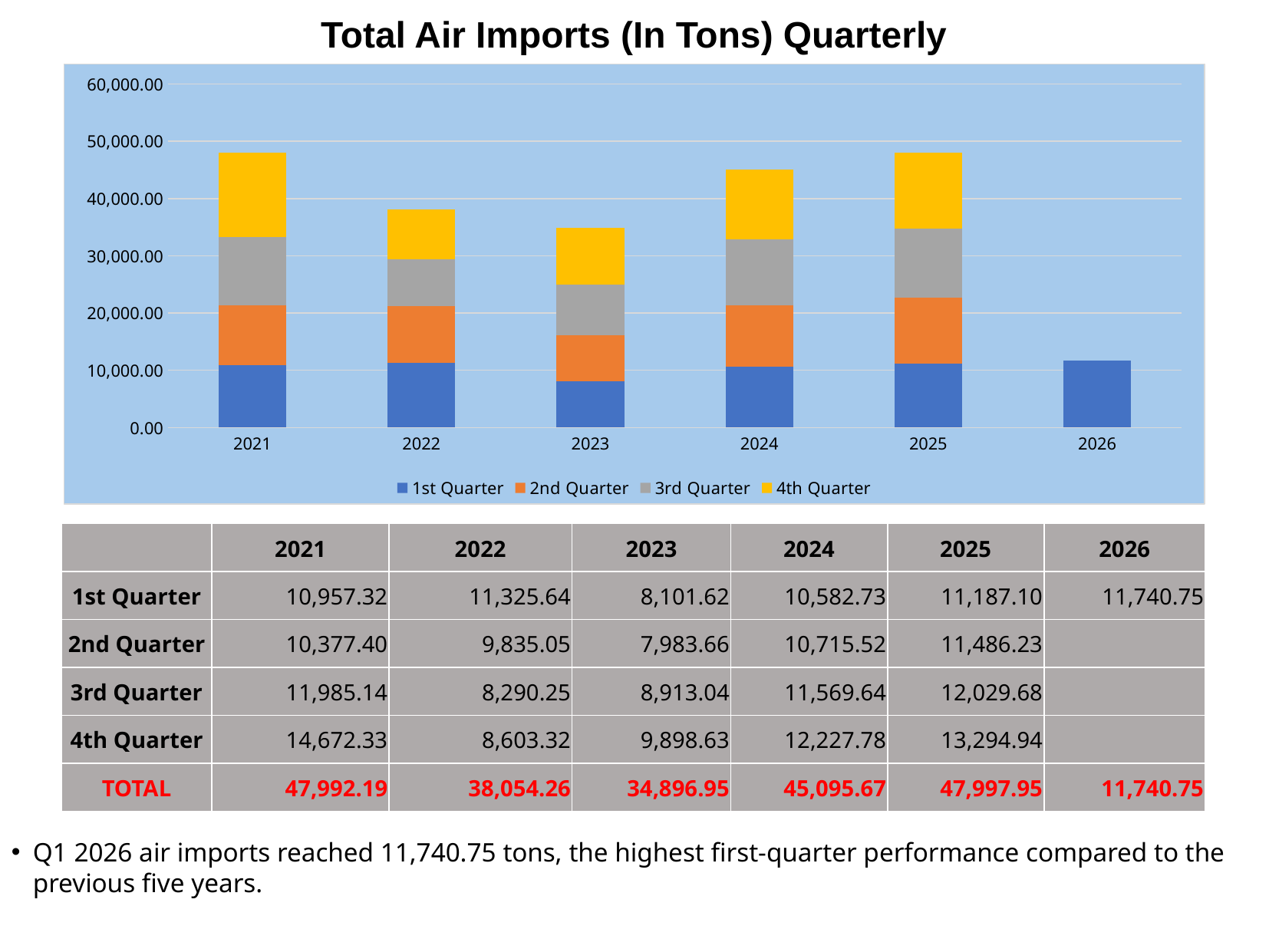
What is the total of the stacked bar for 2022? 38,054.26 How many series does the legend list? 4 Do the total stacked values rise or fall from 2021 to 2023? fall Which year has the lowest 4th Quarter value? 2022 Is the total stacked value for 2023 greater or less than 40,000? less How many years are shown on the x axis of the chart? 6 What kind of chart is shown on the slide? Stacked bar chart What is the 1st Quarter value for 2023? 8,101.62 What is the 4th Quarter value for 2025? 13,294.94 Which is larger, the 2nd Quarter value for 2024 or the 2nd Quarter value for 2021? 2024 Which year has the highest 1st Quarter value? 2026 What is the difference between the 4th Quarter value for 2021 and the 4th Quarter value for 2022? 6,069.01